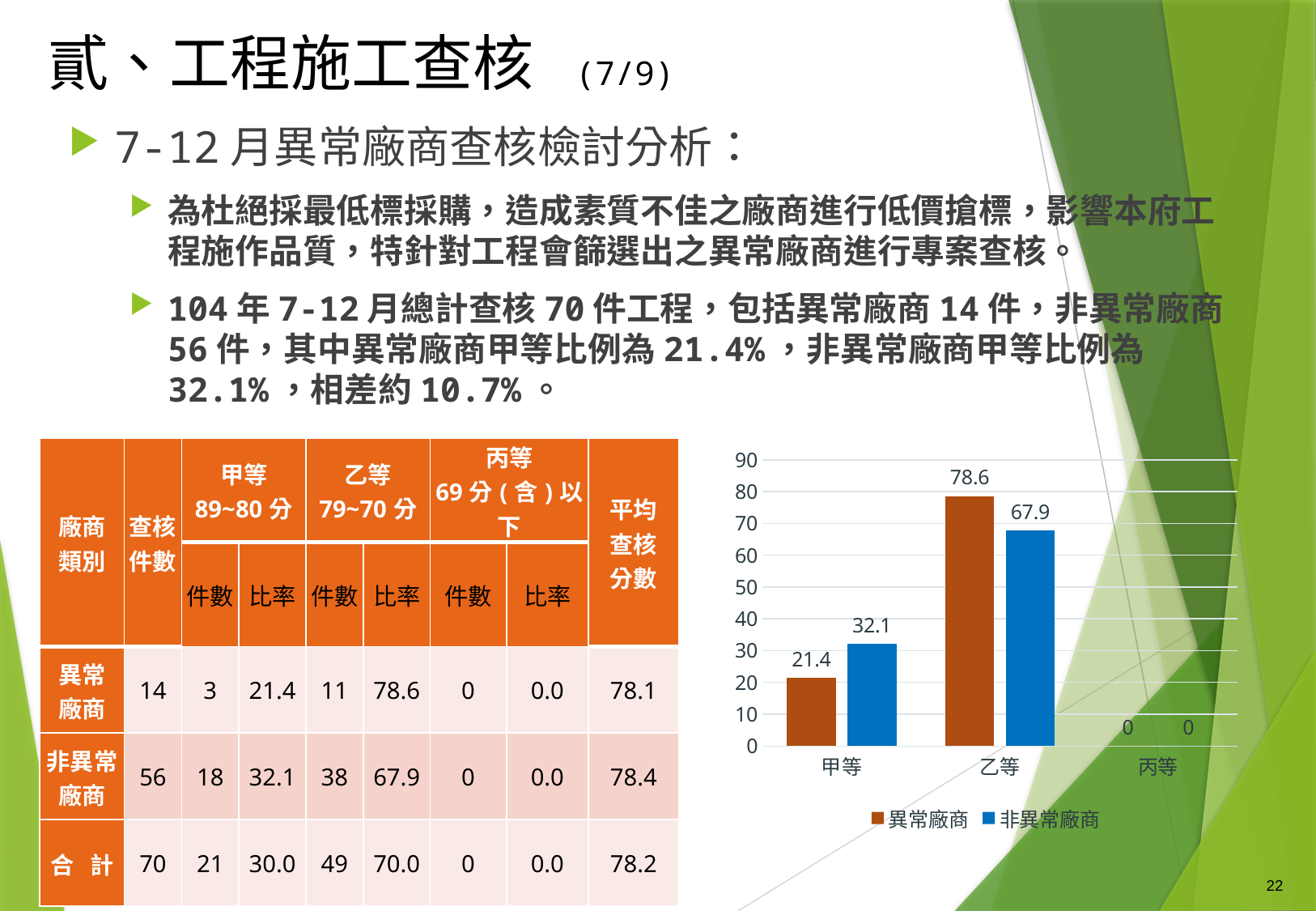
How many series does the chart legend list? 2 How many categories are shown on the x axis of the chart? 3 In the 甲等 category, which series has the larger value, 異常廠商 or 非異常廠商? 非異常廠商 What is the value for 非異常廠商 in the 乙等 category? 67.9 What type of chart is shown on the slide? bar chart What is the value for 非異常廠商 in the 甲等 category? 32.1 Which category has the highest value for 異常廠商? 乙等 What is the value for 異常廠商 in the 乙等 category? 78.6 What is the difference between 異常廠商 and 非異常廠商 in the 乙等 category? 10.7 What is the value for 異常廠商 in the 甲等 category? 21.4 What is the value for 異常廠商 in the 丙等 category? 0 Which category has the lowest value for 非異常廠商? 丙等